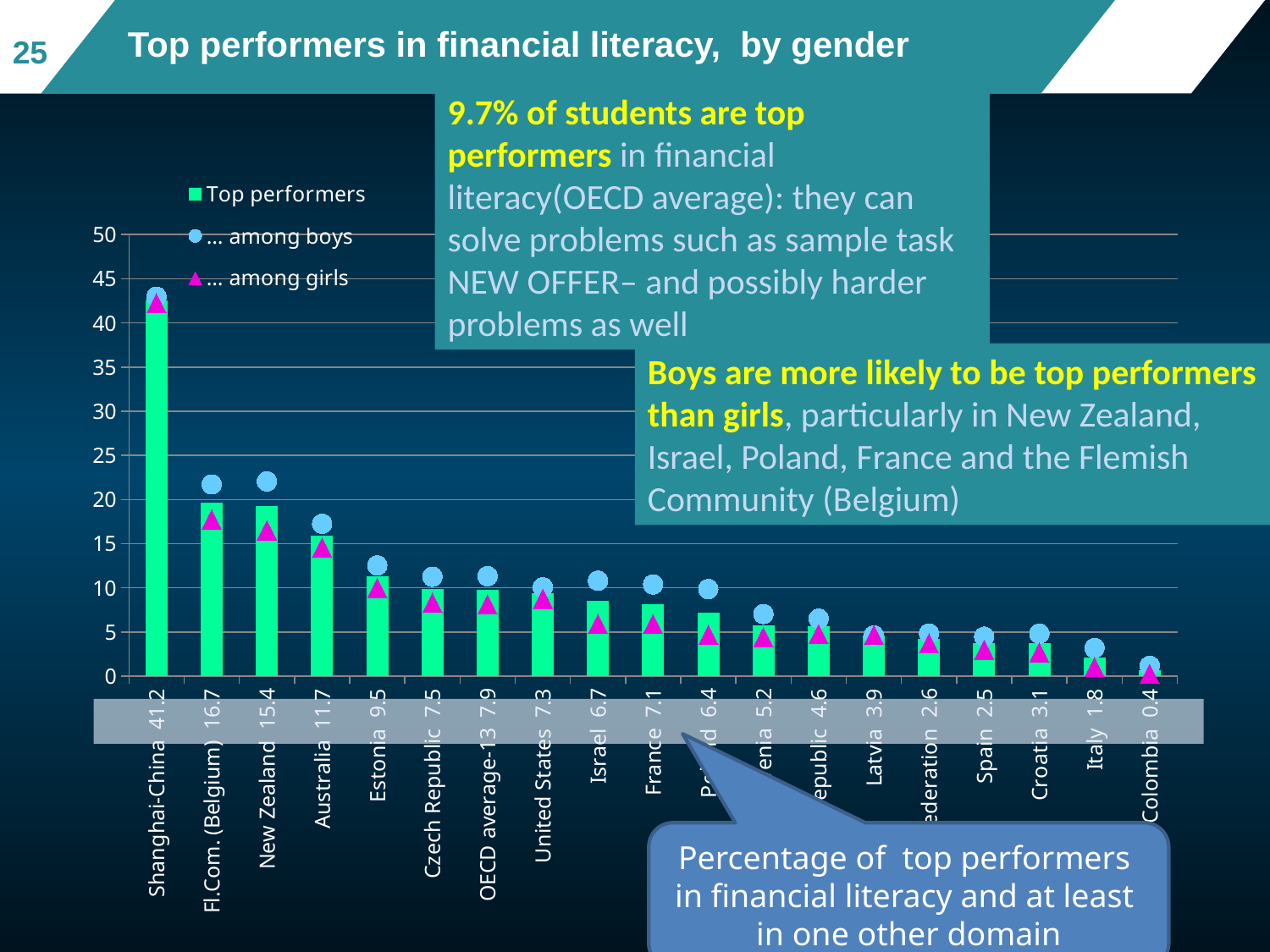
Is the Top performers value for Shanghai-China greater or less than 40? greater How many countries/economies are plotted along the x axis? 19 In New Zealand, which is higher: the share of top performers among boys or among girls? among boys Which country/economy has the lowest share of top performers? Colombia Which country/economy has the highest share of top performers? Shanghai-China What kind of chart is shown on the slide? bar chart Is the Top performers value for Estonia greater or less than 10? greater How many series does the legend list? 3 What are the three entries listed in the chart legend? Top performers; … among boys; … among girls Which has a larger Top performers bar, Australia or Estonia? Australia Do the Top performers values generally rise or fall from left to right along the x axis? fall Is the Top performers value for Colombia greater or less than 5? less